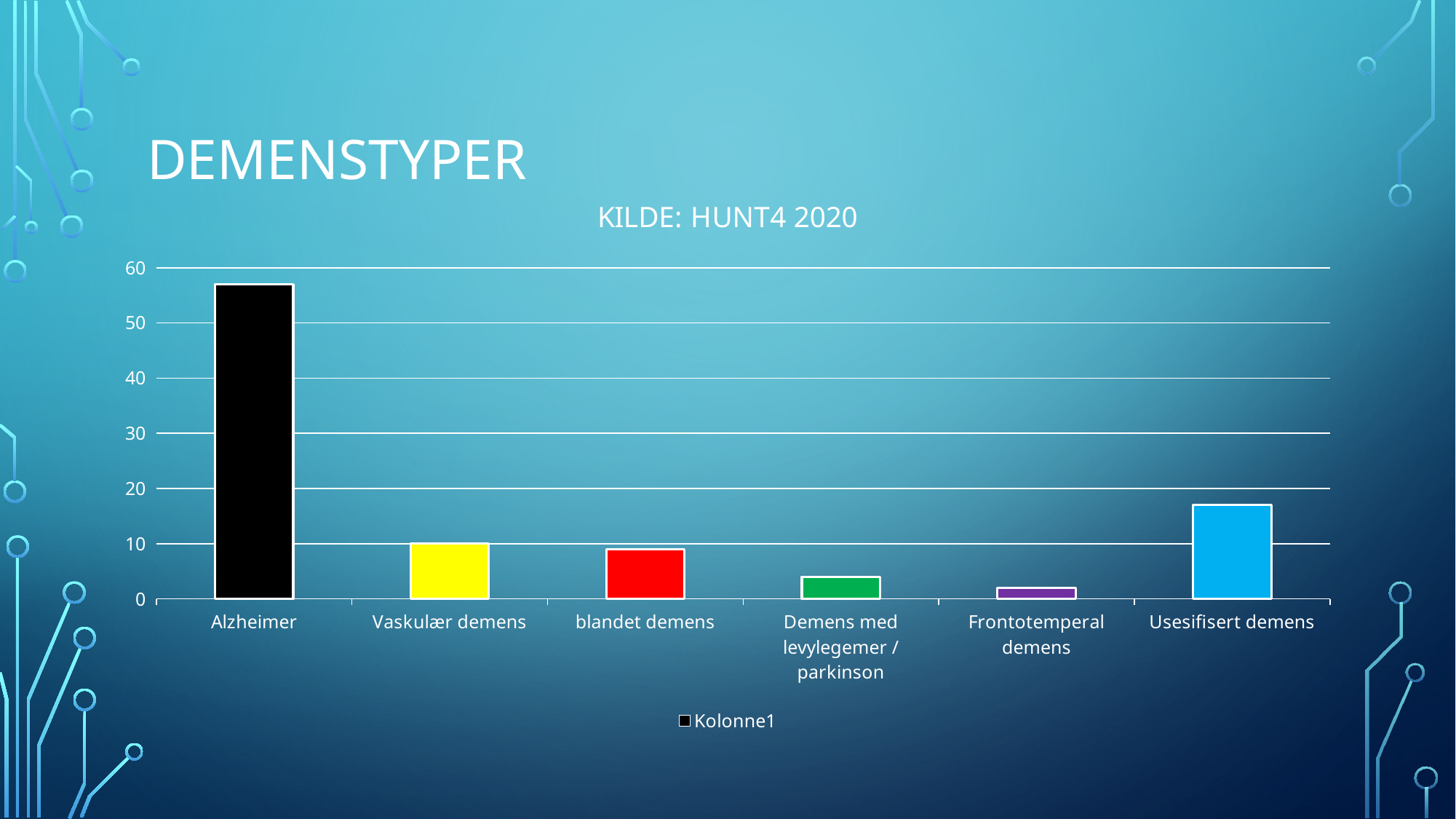
Which category has the lowest value in the chart? Frontotemperal demens How many categories are shown on the x axis of the chart? 6 Is the value for Alzheimer greater or less than 50? greater What is the title of the chart? KILDE: HUNT4 2020 Which is larger, the value for blandet demens or the value for Frontotemperal demens? blandet demens Which is larger, the value for Usesifisert demens or the value for Vaskulær demens? Usesifisert demens Which category has the highest value in the chart? Alzheimer Is the value for Demens med levylegemer / parkinson greater or less than 10? less What kind of chart is shown on the slide? bar chart How many series does the chart legend list? 1 Is the value for Usesifisert demens greater or less than 20? less What is the name of the series in the chart legend? Kolonne1